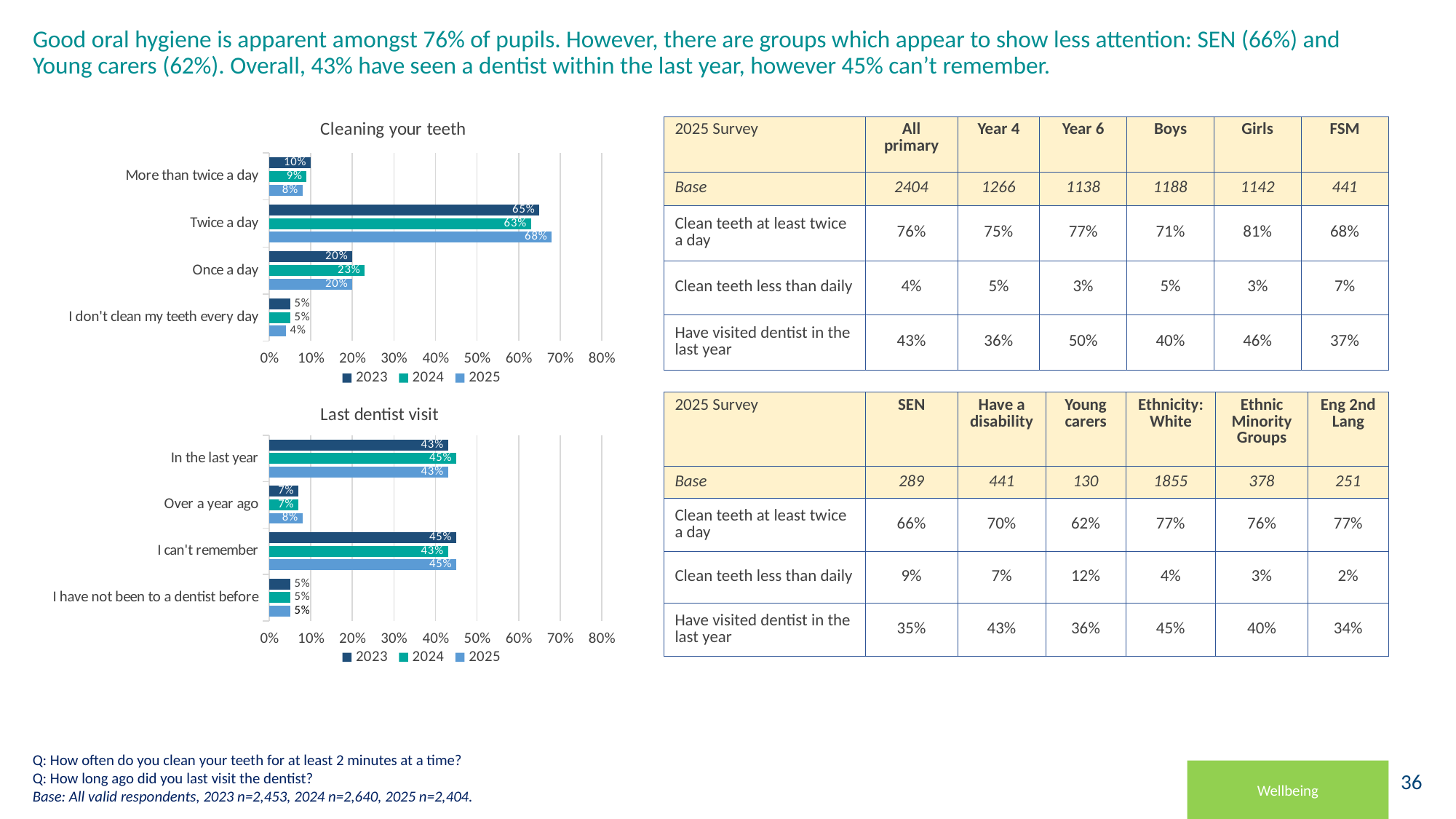
What type of chart is the 'Cleaning your teeth' chart? Bar chart In the 'Last dentist visit' chart, what is the difference between the 2023 values for 'I can't remember' and 'Over a year ago'? 38% In the 'Last dentist visit' chart, what is the 2025 value for 'Over a year ago'? 8% In the 'Cleaning your teeth' chart, which category has the highest 2023 value? Twice a day In the 'Cleaning your teeth' chart, what is the 2025 value for 'Twice a day'? 68% In the 'Last dentist visit' chart, what is the 2024 value for 'In the last year'? 45% How many categories are shown in the 'Last dentist visit' chart? 4 In the 'Last dentist visit' chart, which category has the lowest 2025 value? I have not been to a dentist before In the 'Cleaning your teeth' chart, which is larger for 'More than twice a day': the 2023 value or the 2025 value? 2023 In the 'Cleaning your teeth' chart, what is the difference between the 2023 and 2025 values for 'Twice a day'? 3% How many series does the legend of the 'Cleaning your teeth' chart list? 3 In the 'Cleaning your teeth' chart, what is the 2024 value for 'Once a day'? 23%